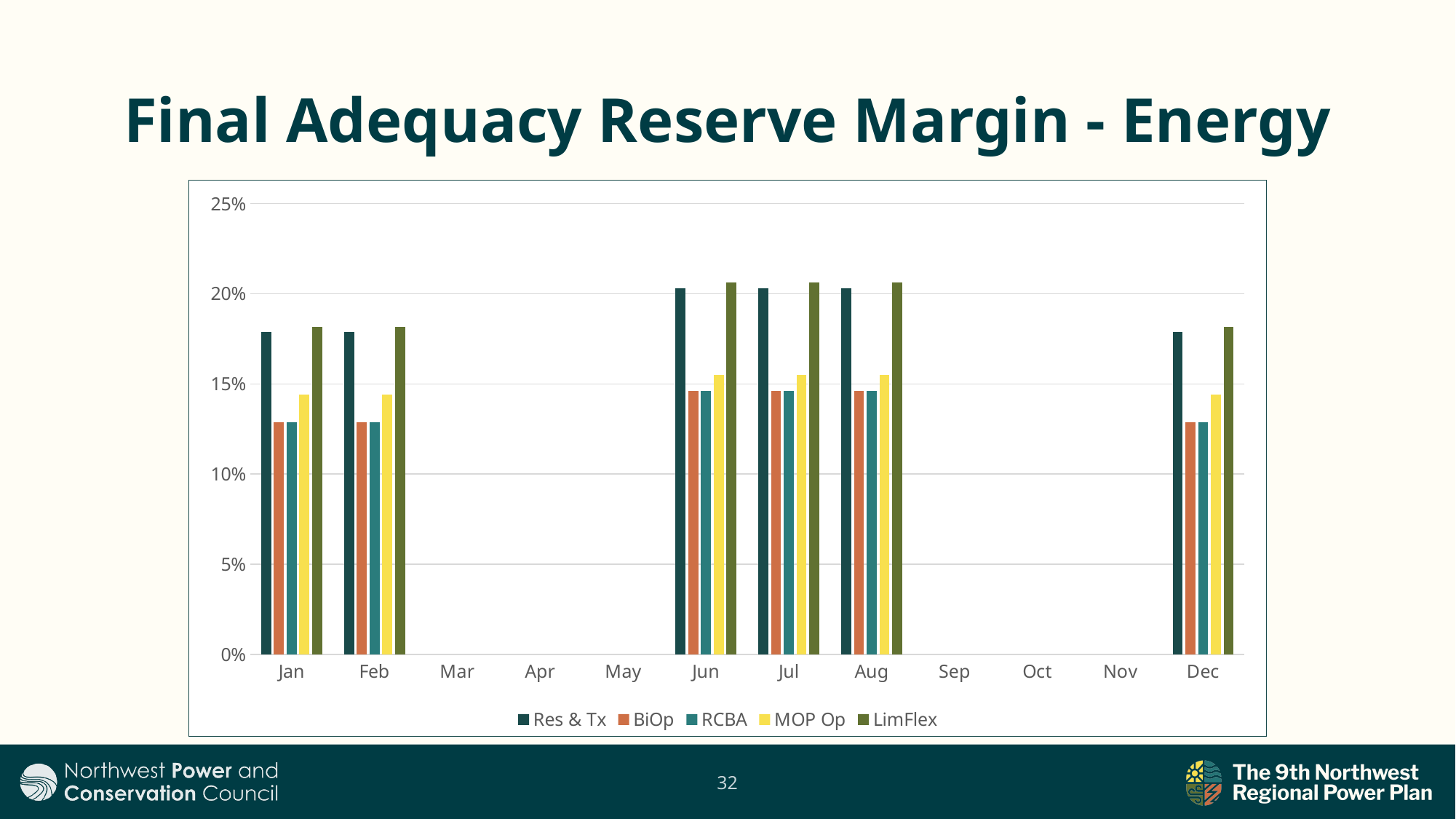
Which series is shown in yellow in the legend? MOP Op Is the value for LimFlex in Dec greater or less than 20%? less What is the title of the slide? Final Adequacy Reserve Margin - Energy How many months are shown on the x axis? 12 Is the value for Res & Tx in Jun greater or less than 15%? greater Which is larger in Jan, MOP Op or BiOp? MOP Op How many series does the legend list? 5 Is the value for Res & Tx in Jan greater or less than 15%? greater What kind of chart is shown on the slide? bar chart Which is larger, the Res & Tx value in Jun or the Res & Tx value in Jan? Jun How many months have bars plotted? 6